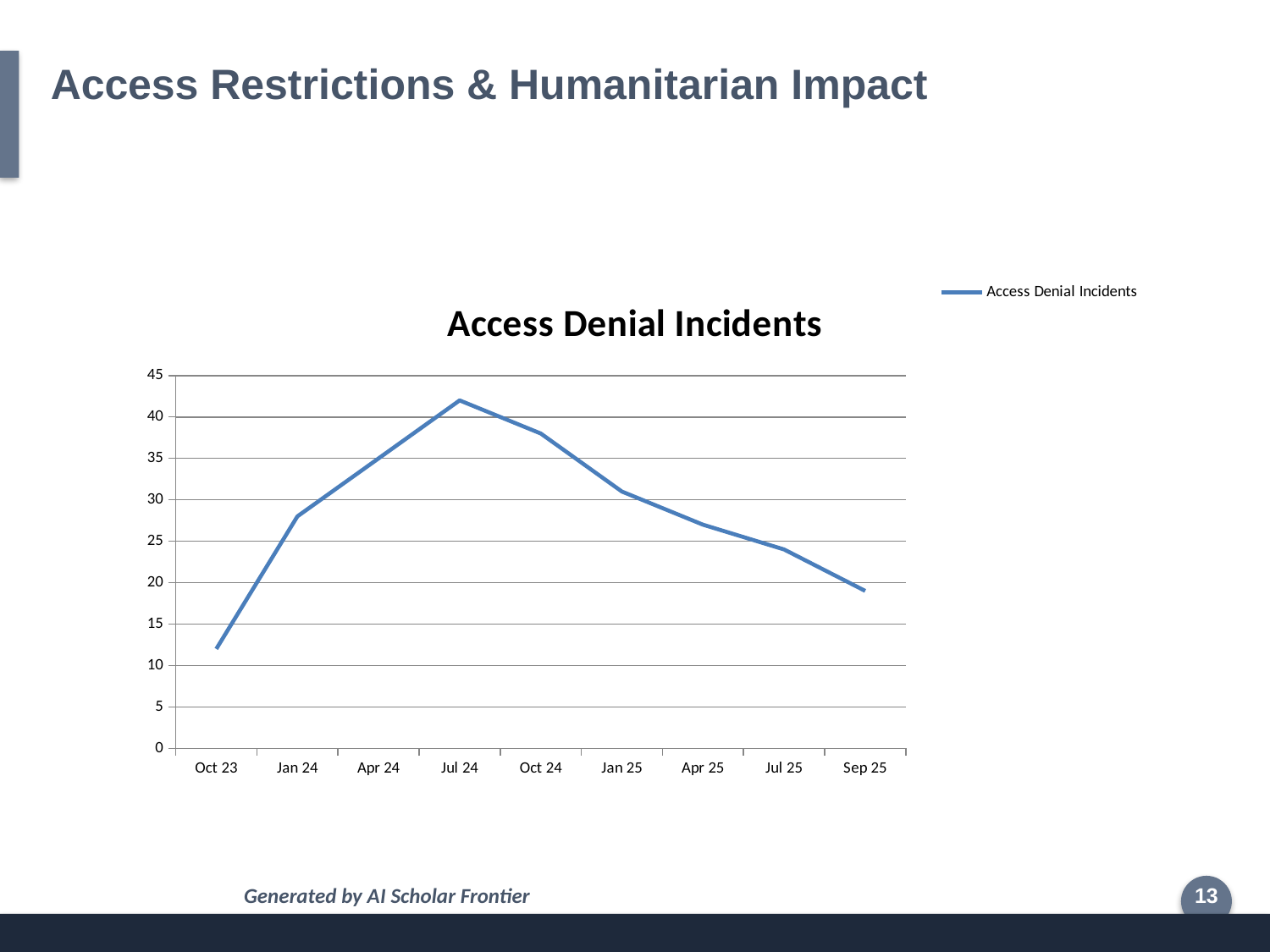
At which point on the x axis is the value of Access Denial Incidents lowest? Oct 23 Is the value for Oct 23 greater or less than 15? less How many series does the legend list? 1 Is the value for Oct 24 greater or less than 35? greater Which is larger, the value for Jan 24 or the value for Sep 25? Jan 24 How many points are plotted along the x axis? 9 Do the values rise or fall from Jul 24 to Sep 25? fall At which point on the x axis is the value of Access Denial Incidents highest? Jul 24 What kind of chart is shown on the slide? line chart What is the title of the chart? Access Denial Incidents Is the value for Jul 24 greater or less than 40? greater